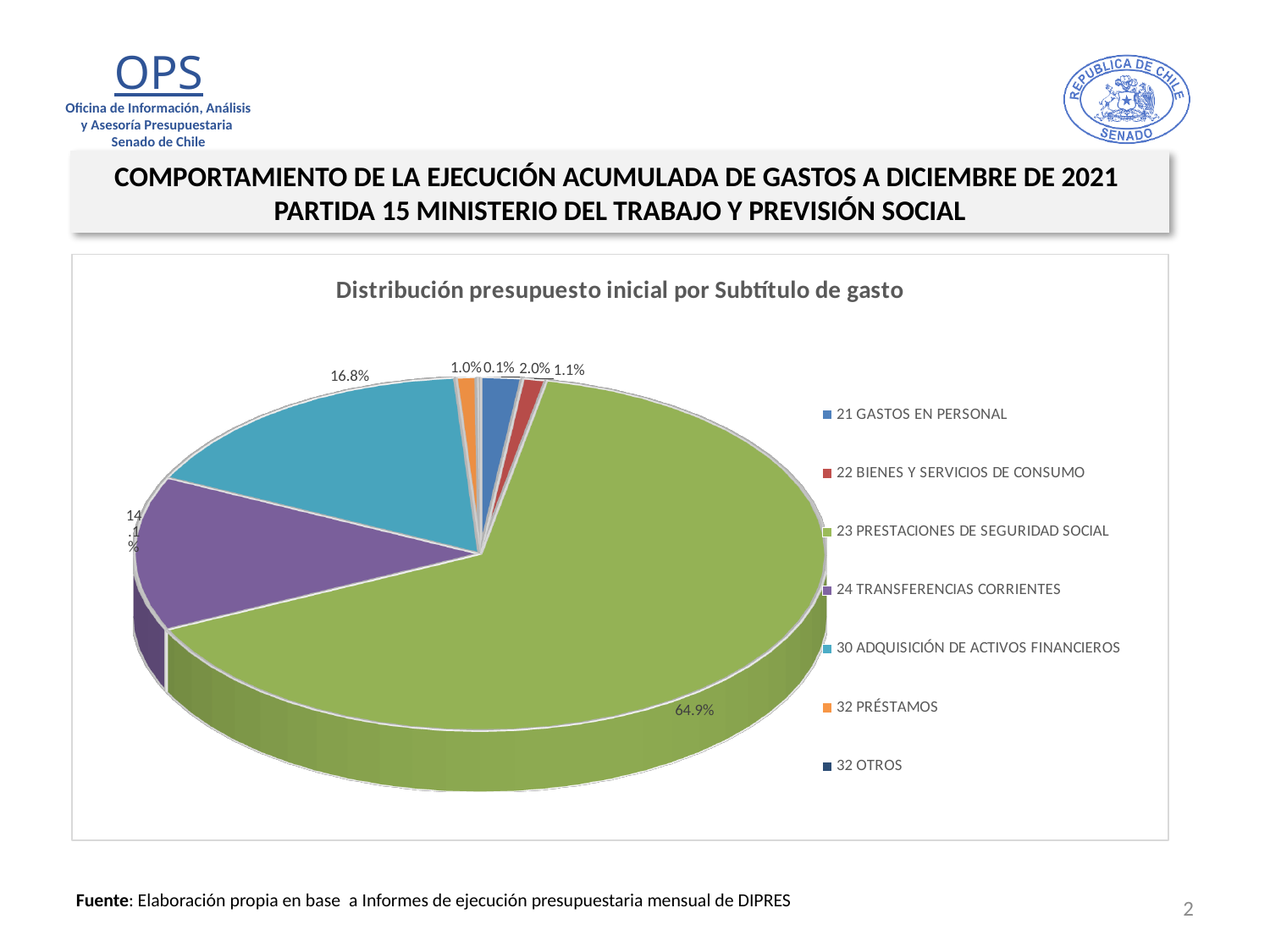
What share of the pie corresponds to 32 PRÉSTAMOS? 1.0% What type of chart is shown on the slide? Pie chart What is the difference in percentage points between the shares of 30 ADQUISICIÓN DE ACTIVOS FINANCIEROS and 24 TRANSFERENCIAS CORRIENTES? 2.7 percentage points What share of the pie corresponds to 23 PRESTACIONES DE SEGURIDAD SOCIAL? 64.9% Which category has the largest share of the pie? 23 PRESTACIONES DE SEGURIDAD SOCIAL Which category has the smallest share of the pie? 32 OTROS What share of the pie corresponds to 24 TRANSFERENCIAS CORRIENTES? 14.1% What share of the pie corresponds to 30 ADQUISICIÓN DE ACTIVOS FINANCIEROS? 16.8% What share of the pie corresponds to 21 GASTOS EN PERSONAL? 2.0% How many categories does the legend list? 7 What share of the pie corresponds to 22 BIENES Y SERVICIOS DE CONSUMO? 1.1% What is the title of the chart? Distribución presupuesto inicial por Subtítulo de gasto